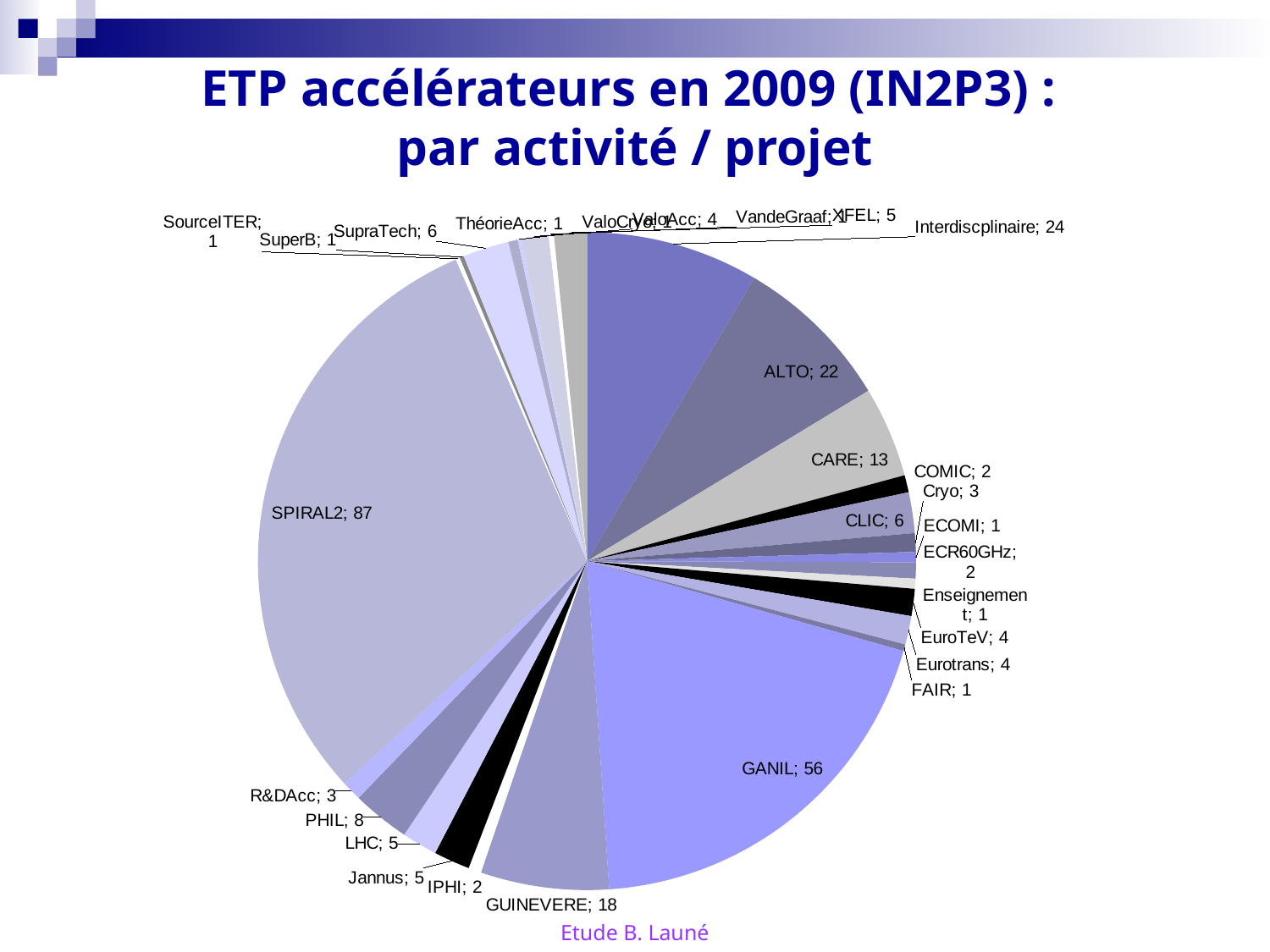
What kind of chart is shown on the slide? pie chart What is the value shown for ALTO? 22 What is the value shown for GANIL? 56 What is the title of the chart on the slide? ETP accélérateurs en 2009 (IN2P3) : par activité / projet What is the value shown for CARE? 13 Which activity/project has the largest slice of the pie? SPIRAL2 What is the value shown for SPIRAL2? 87 Which has the larger value, Interdiscplinaire or ALTO? Interdiscplinaire What is the value shown for PHIL? 8 Which has the larger value, GUINEVERE or CARE? GUINEVERE What is the difference between the values for SPIRAL2 and GANIL? 31 What is the value shown for GUINEVERE? 18